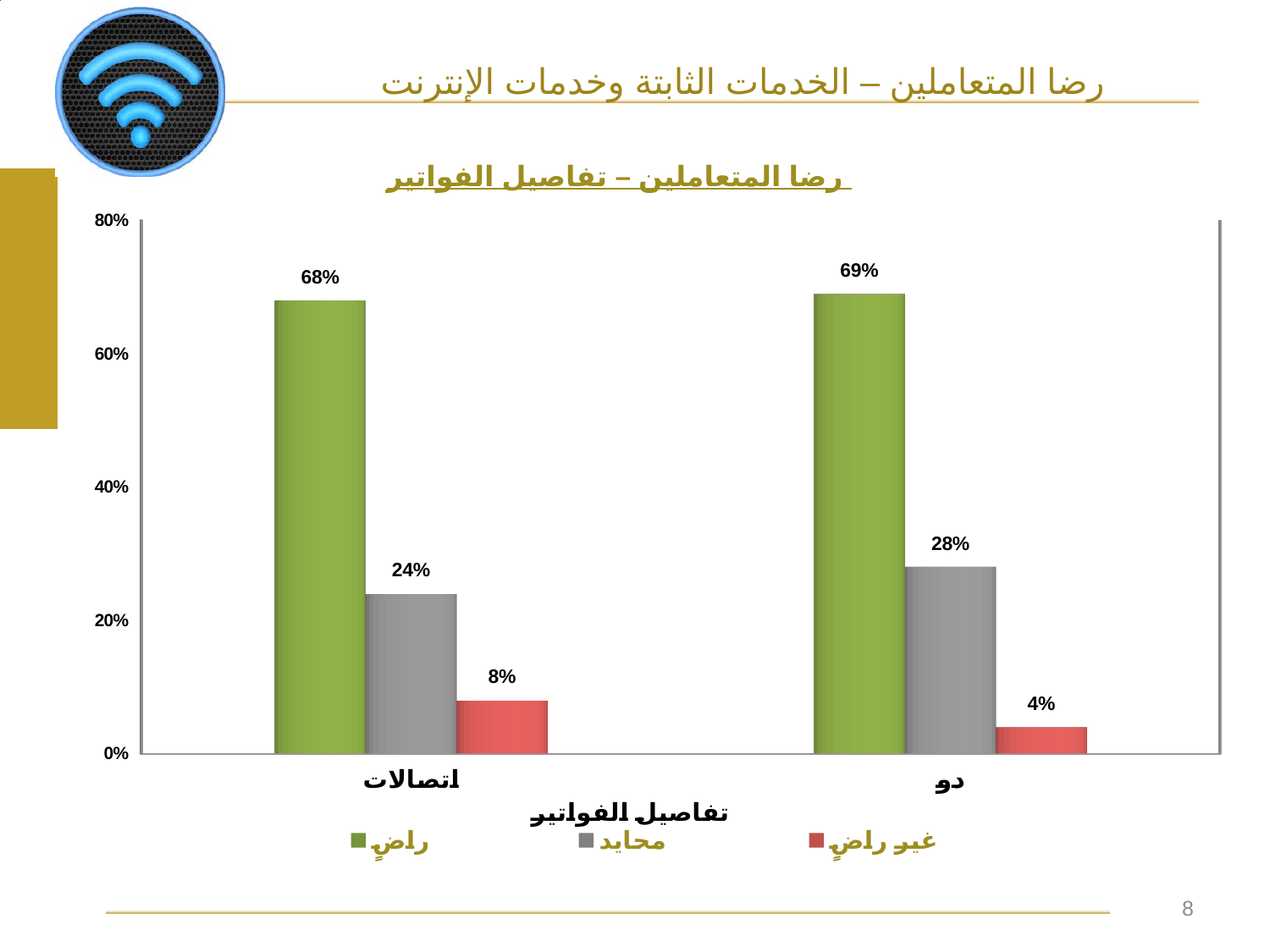
What kind of chart is shown on the slide? Bar chart Is the value for محايد for اتصالات larger than the value for غير راضٍ for اتصالات? Yes Which series has the lowest value for دو? غير راضٍ How many series does the legend list? 3 What is the value for غير راضٍ for اتصالات? 8% What is the value for راضٍ for دو? 69% How many categories are shown on the x axis? 2 What is the value for راضٍ for اتصالات? 68% What is the value for محايد for دو? 28% What is the difference between the محايد values for دو and اتصالات? 4% Which category has the higher value for غير راضٍ? اتصالات What is the title of the chart? رضا المتعاملين – تفاصيل الفواتير